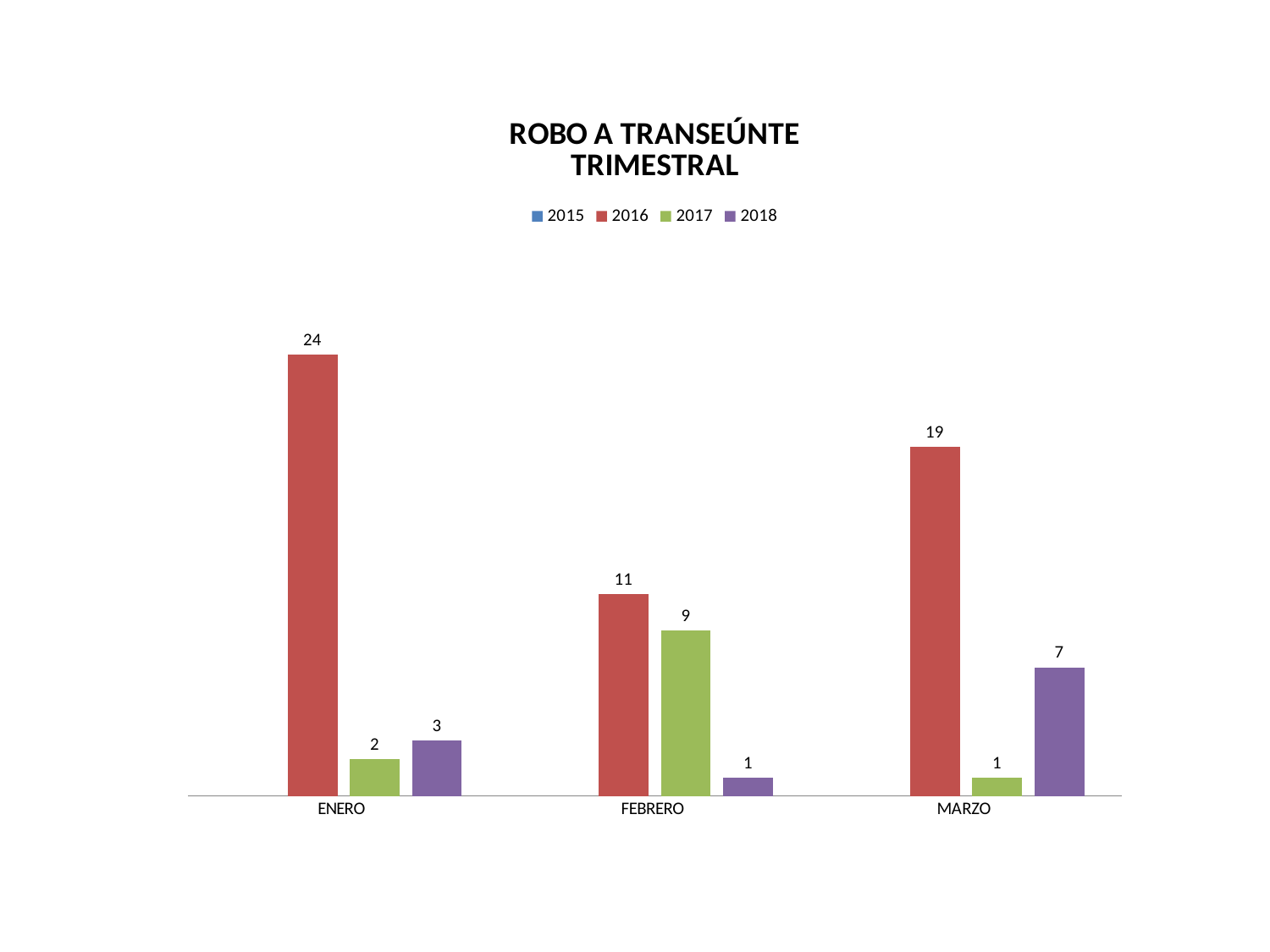
How many months are shown on the x axis? 3 What is the title of the chart? ROBO A TRANSEÚNTE TRIMESTRAL What is the value for 2016 in ENERO? 24 What kind of chart is shown? bar chart What is the value for 2018 in MARZO? 7 How many series does the legend list? 4 In which month is the 2016 value highest? ENERO What is the difference between the 2016 values for ENERO and MARZO? 5 In which month is the 2018 value lowest? FEBRERO What is the value for 2017 in FEBRERO? 9 What is the value for 2018 in FEBRERO? 1 Which is larger in FEBRERO, the 2016 value or the 2017 value? 2016